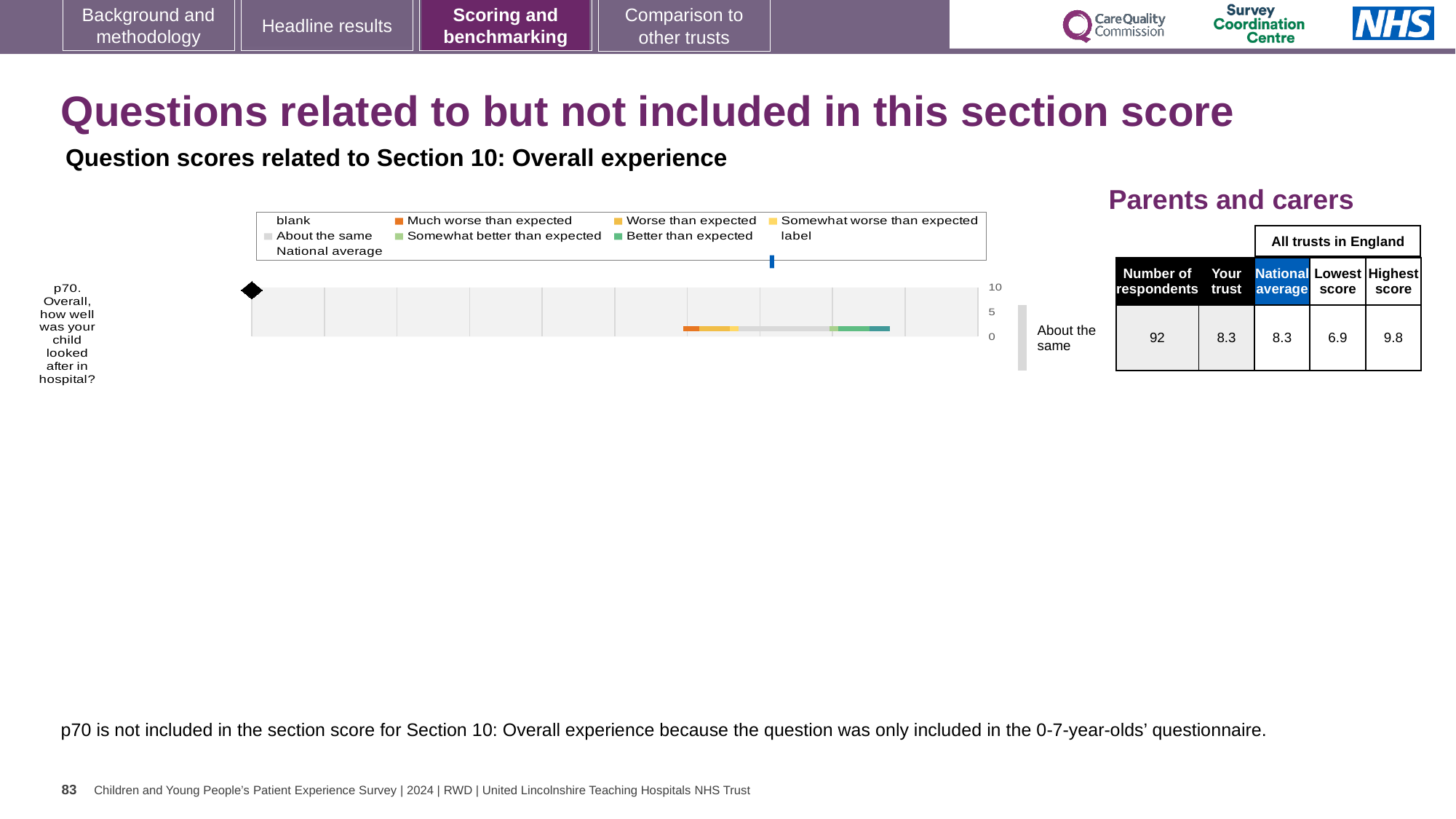
What category label is shown to the right of the p70 bar? About the same In the table next to the chart, what is the number of respondents for p70? 92 Which question is plotted in the chart? p70. Overall, how well was your child looked after in hospital? What is the difference between the highest score and the lowest score for p70 in the table next to the chart? 2.9 In the table next to the chart, what is the lowest score among all trusts in England for p70? 6.9 In the table next to the chart, what is the national average for p70? 8.3 How many questions are plotted in the chart? 1 What is the highest value shown on the chart's axis? 10 In the table next to the chart, what is the 'Your trust' score for p70? 8.3 Is the 'Your trust' score for p70 larger or smaller than the national average? equal In the table next to the chart, what is the highest score among all trusts in England for p70? 9.8 What kind of chart is used to show the p70 question scores? bar chart